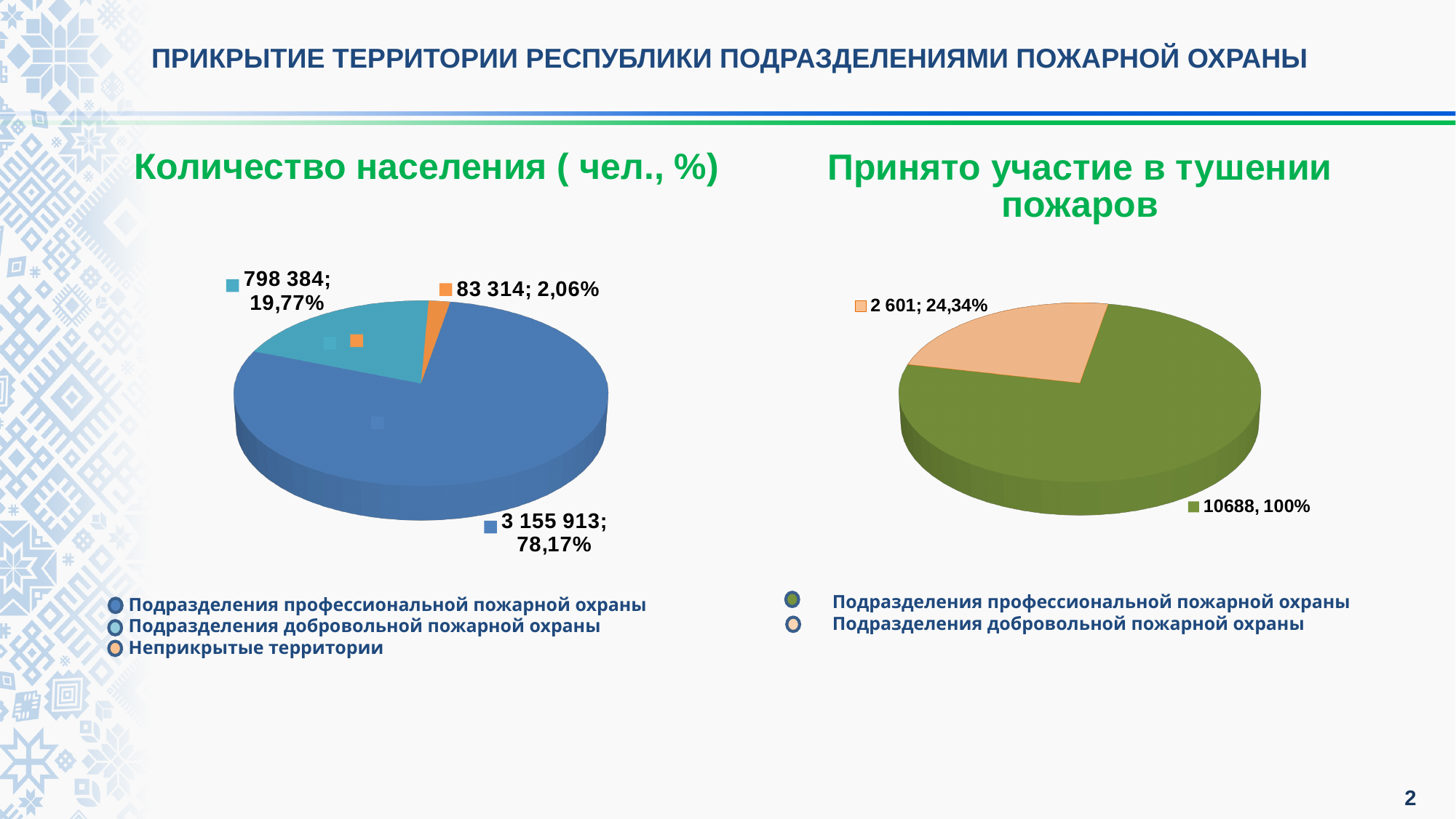
In the chart titled "Количество населения ( чел., %)", what share of the pie does "Подразделения добровольной пожарной охраны" take? 19,77% In the chart titled "Принято участие в тушении пожаров", how many entries does the legend list? 2 In the chart titled "Количество населения ( чел., %)", what is the value for "Подразделения профессиональной пожарной охраны"? 3 155 913; 78,17% In the chart titled "Количество населения ( чел., %)", what is the value for "Подразделения добровольной пожарной охраны"? 798 384; 19,77% In the chart titled "Принято участие в тушении пожаров", which category has the larger slice? Подразделения профессиональной пожарной охраны What type of chart is shown on the right side of the slide? Pie chart In the chart titled "Количество населения ( чел., %)", how many slices does the pie have? 3 In the chart titled "Количество населения ( чел., %)", which category has the smallest slice? Неприкрытые территории In the chart titled "Принято участие в тушении пожаров", what is the value for "Подразделения добровольной пожарной охраны"? 2 601; 24,34% In the chart titled "Количество населения ( чел., %)", which category has the largest slice? Подразделения профессиональной пожарной охраны In the chart titled "Количество населения ( чел., %)", what is the value for "Неприкрытые территории"? 83 314; 2,06%